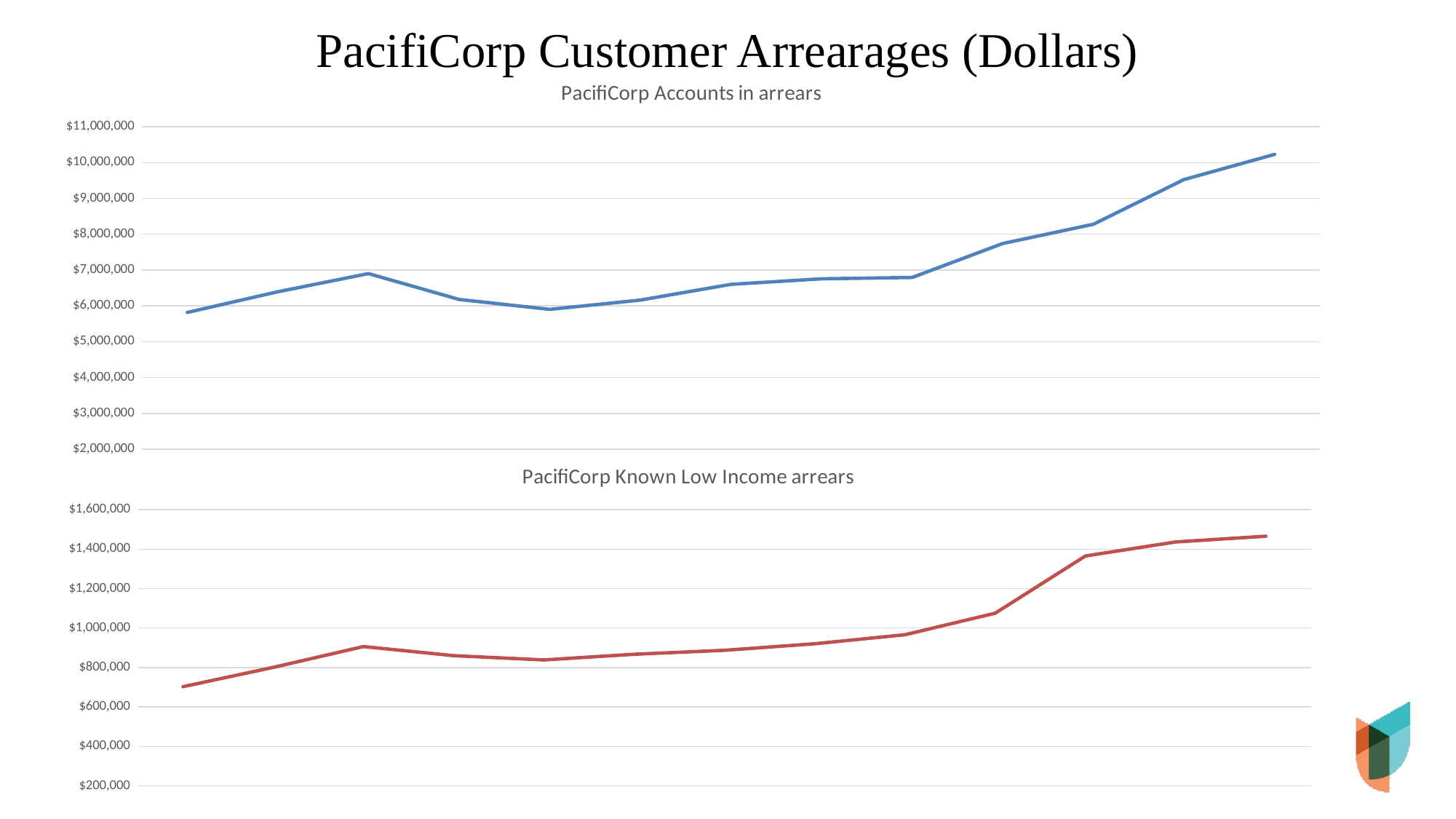
In the top chart "PacifiCorp Accounts in arrears", which point has the highest value, the first or the last? the last What kind of chart is the top chart titled "PacifiCorp Accounts in arrears"? line chart In the top chart "PacifiCorp Accounts in arrears", is the value of the first (leftmost) point greater or less than $7,000,000? less In the bottom chart "PacifiCorp Known Low Income arrears", is the value of the first (leftmost) point greater or less than $800,000? less What is the highest value shown on the y axis of the top chart "PacifiCorp Accounts in arrears"? $11,000,000 In the bottom chart "PacifiCorp Known Low Income arrears", which point has the lowest value, the first or the last? the first In the bottom chart "PacifiCorp Known Low Income arrears", do the values overall rise or fall from left to right? rise In the top chart "PacifiCorp Accounts in arrears", is the value of the last (rightmost) point greater or less than $10,000,000? greater What kind of chart is the bottom chart titled "PacifiCorp Known Low Income arrears"? line chart What colour is the line in the bottom chart "PacifiCorp Known Low Income arrears"? red In the top chart "PacifiCorp Accounts in arrears", do the values overall rise or fall from left to right? rise